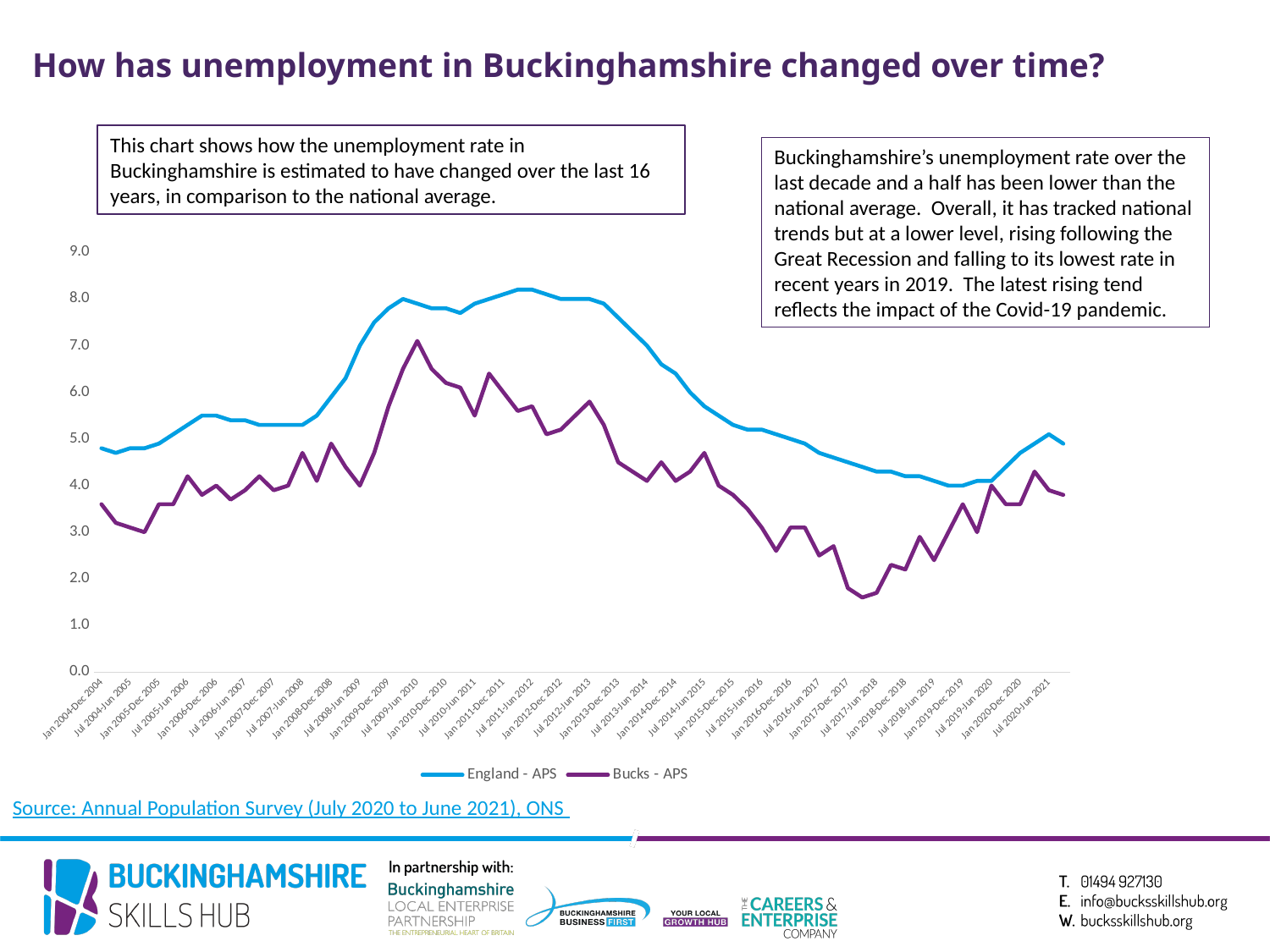
Which series is higher for the period Jan 2018-Dec 2018, England - APS or Bucks - APS? England - APS Does the England - APS line rise or fall between Jan 2012-Dec 2012 and Jan 2019-Dec 2019? Fall Which series is drawn in purple on the chart? Bucks - APS Is the Bucks - APS value for Jan 2004-Dec 2004 greater or less than 3.0? greater Does the Bucks - APS line rise or fall between Jan 2017-Dec 2017 and Jan 2020-Dec 2020? Rise Which series is higher for the period Jan 2010-Dec 2010, England - APS or Bucks - APS? England - APS How many series does the chart's legend list? 2 What kind of chart is shown on the slide? Line chart Is the England - APS value for Jan 2009-Dec 2009 greater or less than 7.0? greater What are the two series named in the chart's legend? England - APS and Bucks - APS Is the Bucks - APS value for Jan 2017-Dec 2017 greater or less than 3.0? less